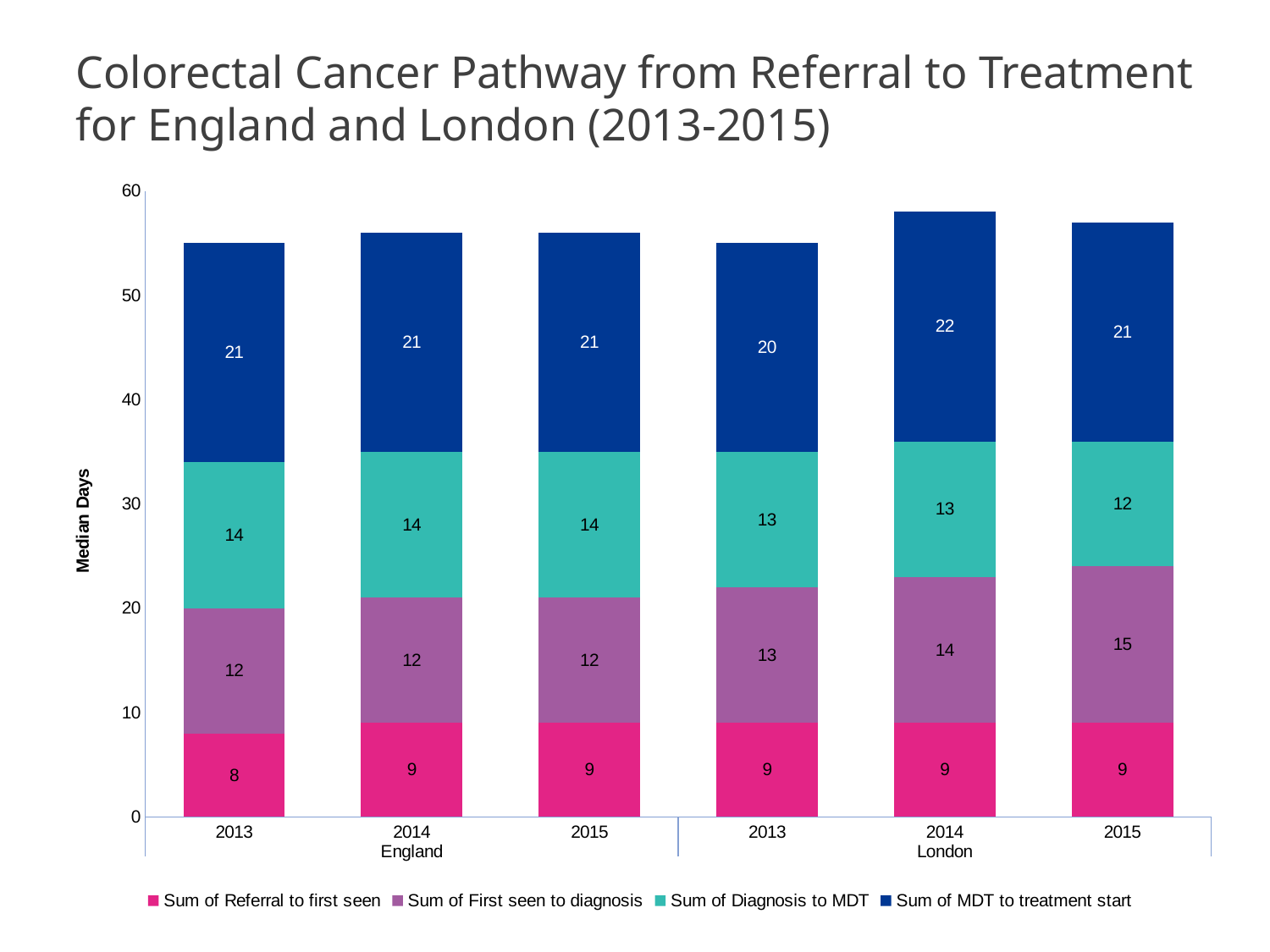
What is the label of the vertical axis? Median Days What type of chart is shown on the slide? Stacked bar chart What is the total of the stacked bar for London in 2014? 58 Which is larger: Sum of Diagnosis to MDT for England in 2014 or for London in 2015? England 2014 Which bar has the highest total median days? London 2014 What is the difference between Sum of First seen to diagnosis for London in 2015 and England in 2015? 3 How many series does the legend list? 4 How many bars are plotted in the chart? 6 What is the value of Sum of First seen to diagnosis for London in 2015? 15 What is the total of the stacked bar for England in 2013? 55 What is the value of Sum of MDT to treatment start for London in 2014? 22 What is the value of Sum of Referral to first seen for England in 2013? 8